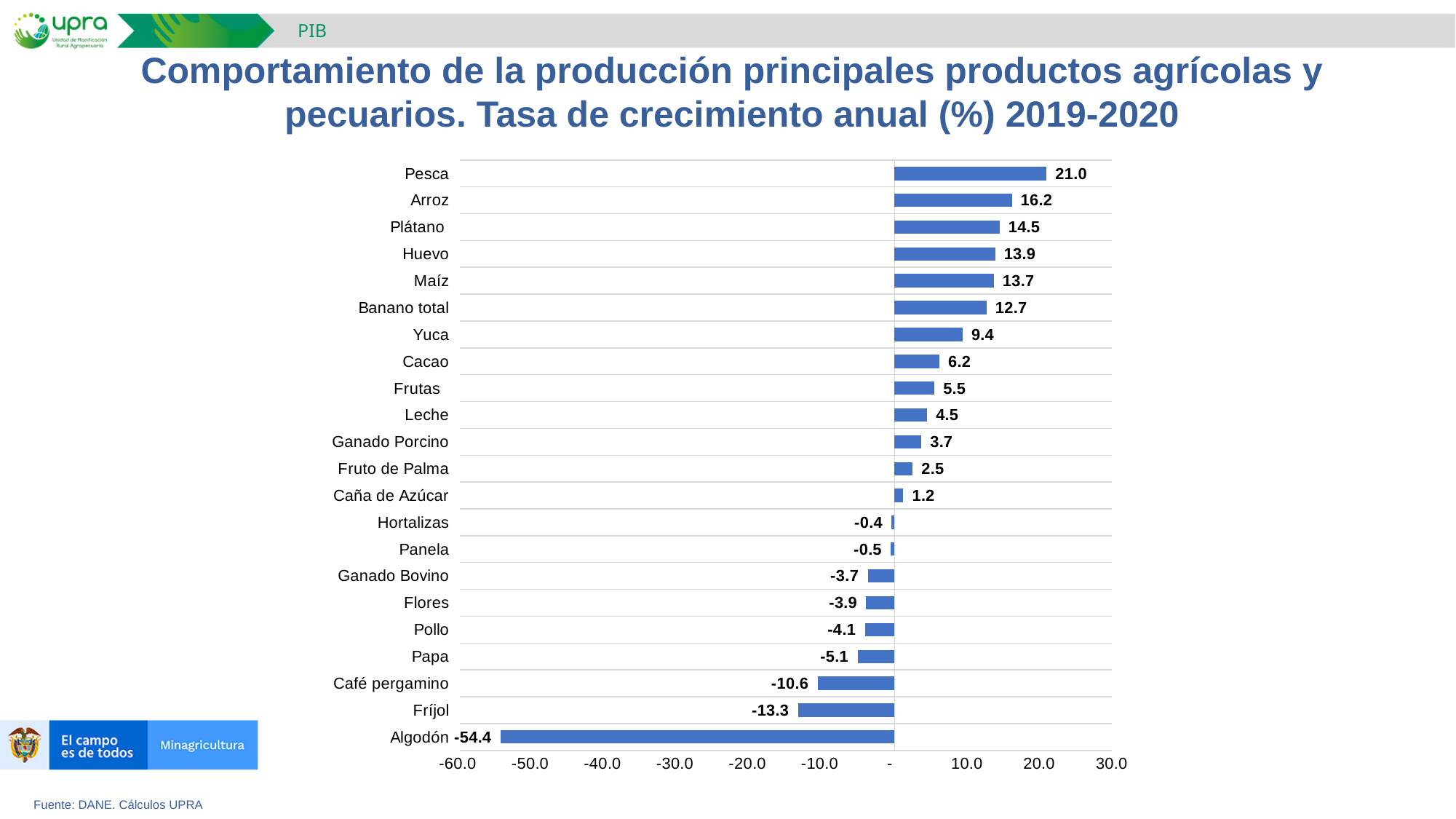
Which has a higher growth rate, Yuca or Cacao? Yuca Which category has the highest growth rate? Pesca What kind of chart is shown on the slide? Bar chart What is the source cited for the chart data? DANE. Cálculos UPRA What is the value shown for Café pergamino? -10.6 What is the value shown for Leche? 4.5 What is the annual growth rate shown for Pesca? 21.0 What is the difference between the values for Fríjol and Algodón? 41.1 What is the difference between the values for Pesca and Arroz? 4.8 Which category has the lowest growth rate? Algodón Is the value for Algodón greater or less than -50.0? less How many categories are shown in the chart? 22